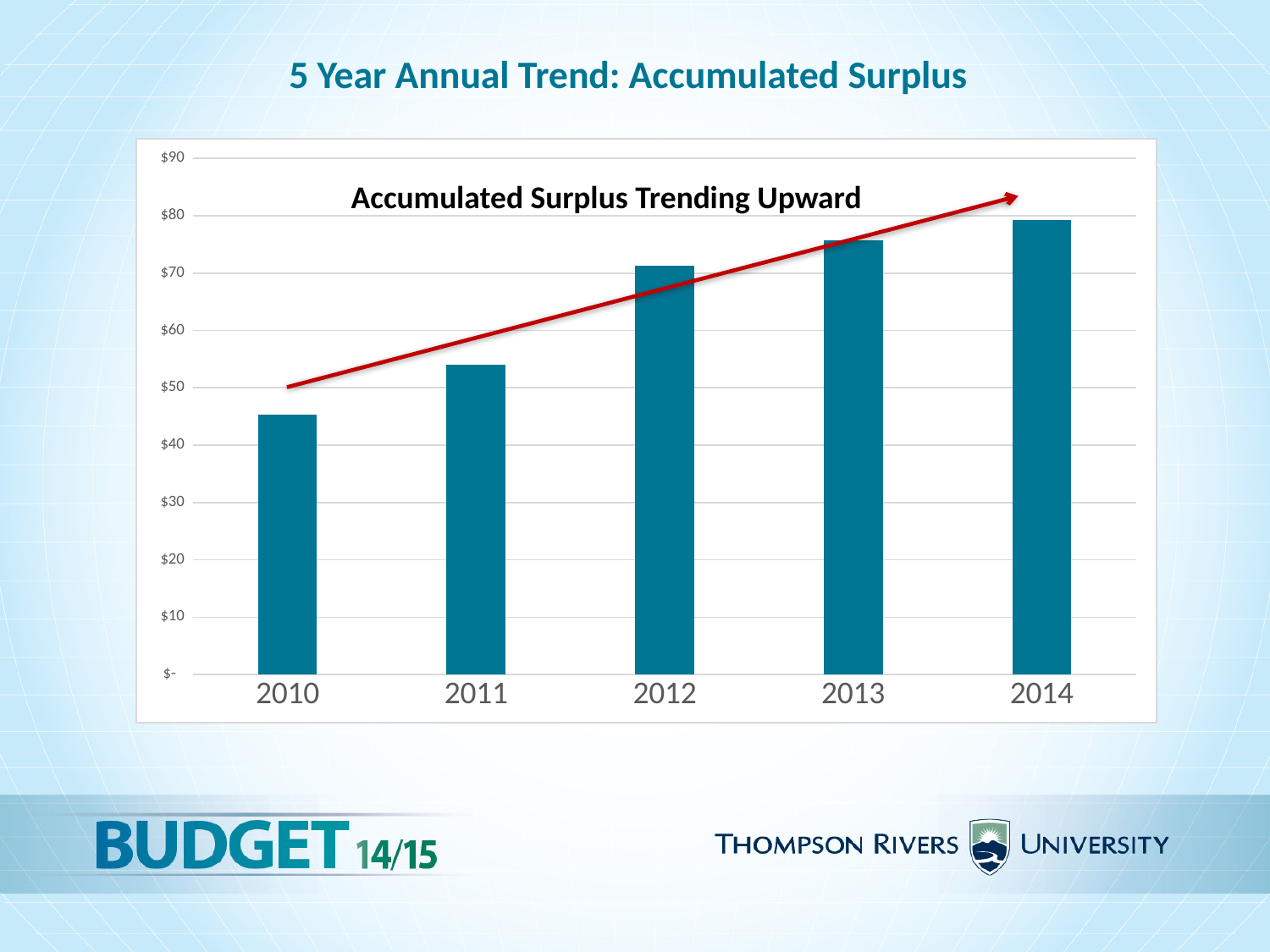
What is the title of the chart? 5 Year Annual Trend: Accumulated Surplus How many years are plotted on the chart? 5 Which year has the lowest accumulated surplus? 2010 Is the value for 2011 greater or less than $50? greater Is the value for 2010 greater or less than $50? less What kind of chart is shown on the slide? Bar chart Which year has the highest accumulated surplus? 2014 Is the value for 2010 greater or less than $40? greater Do the values rise or fall from 2010 to 2014? Rise Which is larger, the value for 2011 or the value for 2012? 2012